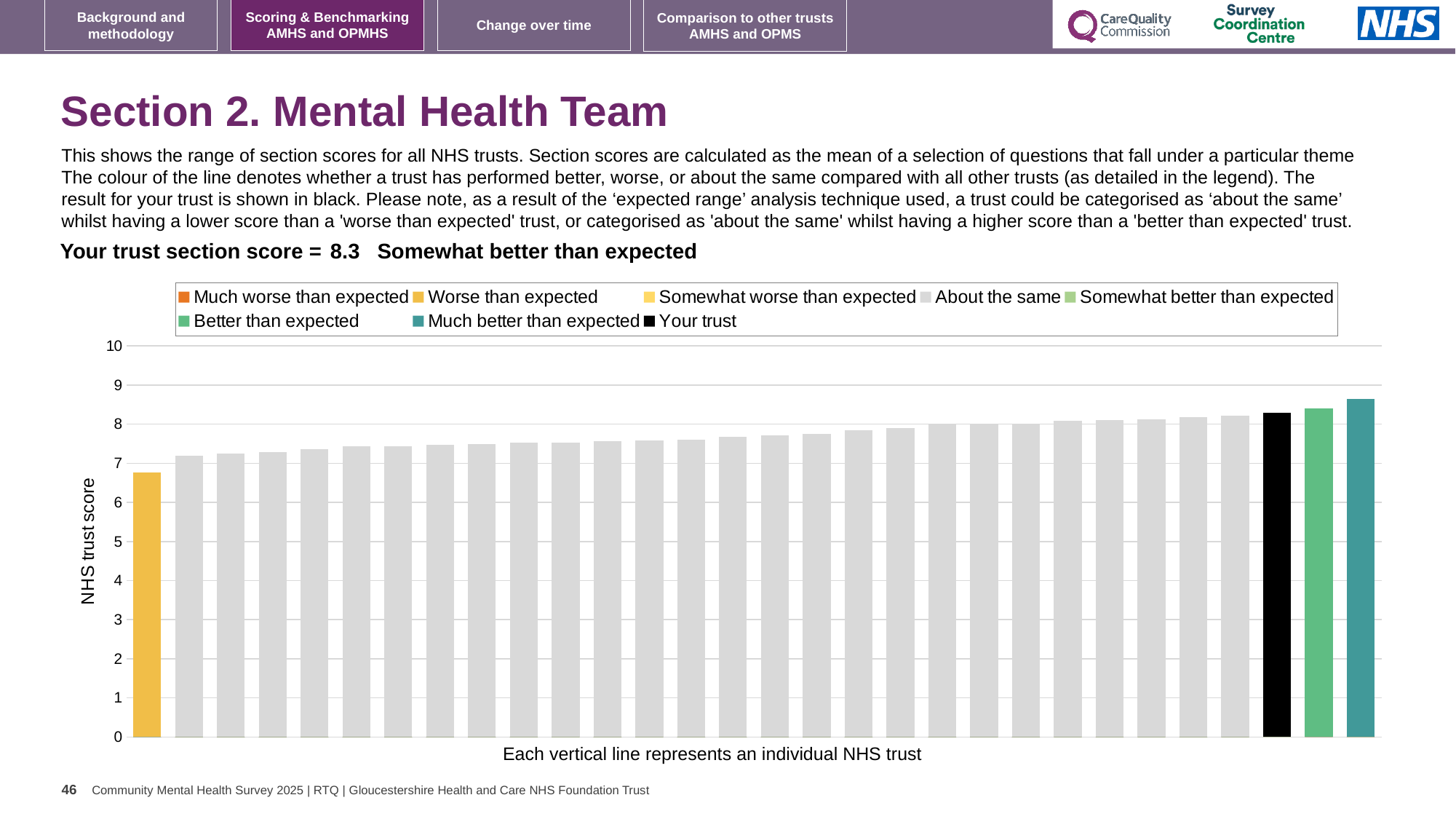
What is the label on the vertical axis of the chart? NHS trust score How many entries does the chart legend list? 8 How is your trust's section score categorised on the slide? Somewhat better than expected What kind of chart is shown on the slide? bar chart Is the value of the black 'Your trust' bar greater or less than 8? greater What is the section score for your trust shown on the slide? 8.3 Is the value of the tallest bar greater or less than 9? less Is the value of the yellow 'Worse than expected' bar greater or less than 7? less Which legend category does the tallest bar in the chart belong to? Much better than expected Which legend category does the shortest bar in the chart belong to? Worse than expected Do the bar values rise or fall from left to right across the chart? rise What colour is the bar representing your trust? black